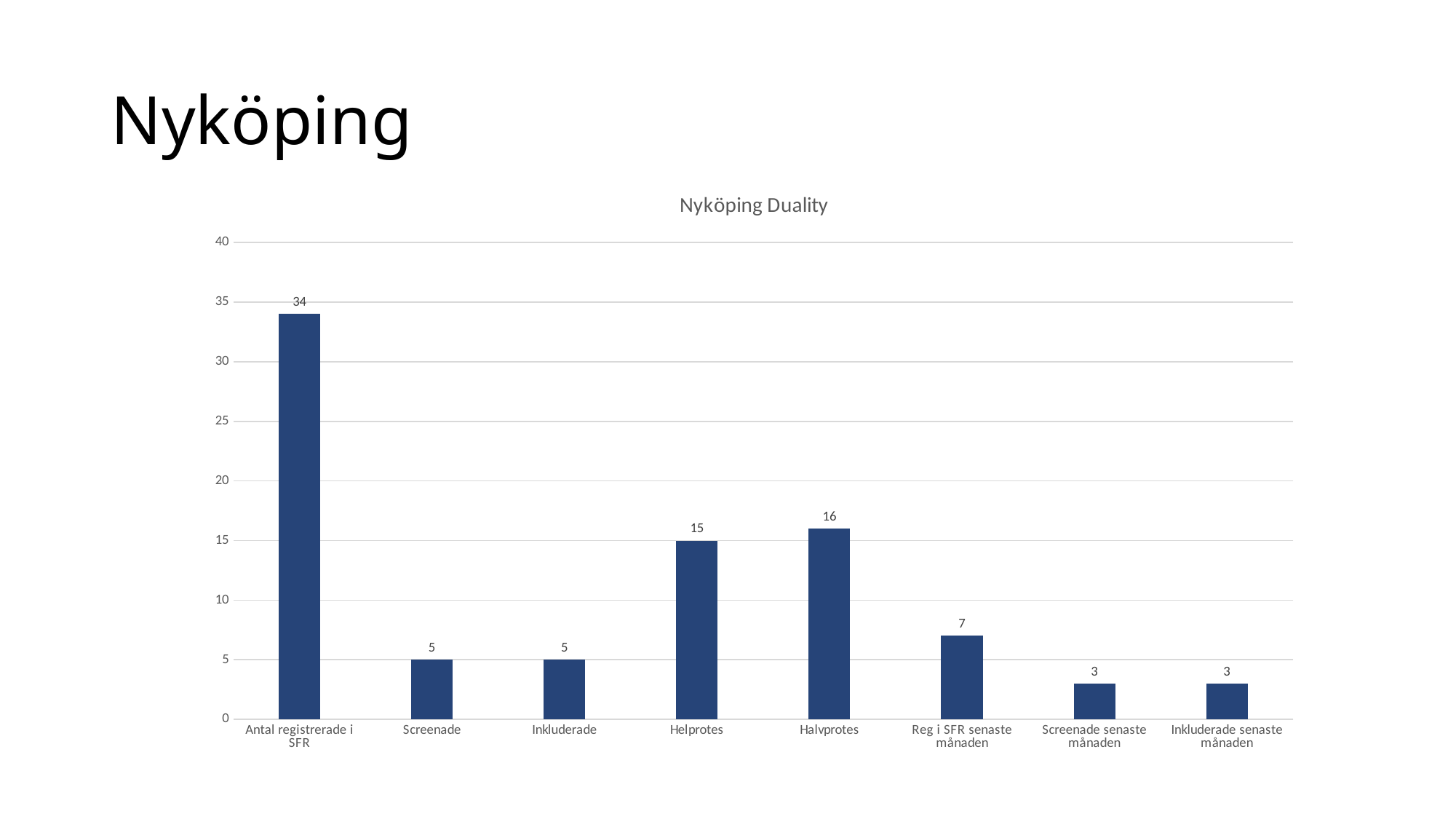
Which category has the highest value? Antal registrerade i SFR How many categories are shown on the x axis? 8 Is the value for Antal registrerade i SFR greater or less than 30? greater What is the value for Halvprotes? 16 What is the value for Reg i SFR senaste månaden? 7 What is the value for Antal registrerade i SFR? 34 Which is larger, Helprotes or Reg i SFR senaste månaden? Helprotes What is the title of the chart? Nyköping Duality What is the difference between Antal registrerade i SFR and Halvprotes? 18 What is the difference between Helprotes and Screenade? 10 What kind of chart is this? bar chart What is the value for Screenade senaste månaden? 3